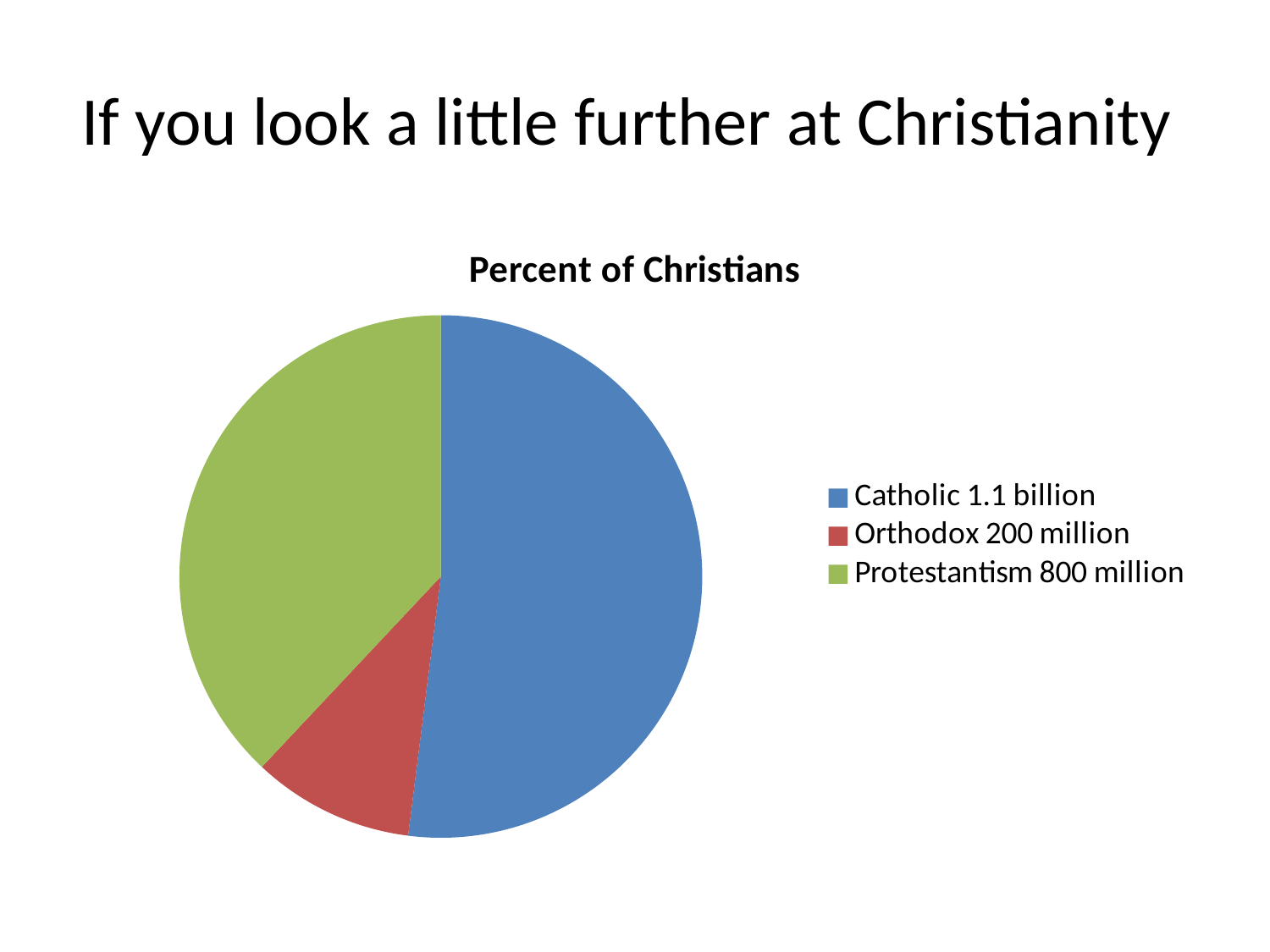
Which group has the smallest slice of the pie? Orthodox What is the title of the chart? Percent of Christians How many slices does the pie chart have? 3 What is the difference between the Protestantism figure and the Orthodox figure shown in the legend? 600 million According to the legend, how many Catholics are there? 1.1 billion Which group has the largest slice of the pie? Catholic Which colour represents Orthodox in the pie chart? Red How many entries does the legend list? 3 What type of chart is shown on the slide? Pie chart According to the legend, how many Orthodox Christians are there? 200 million Which is larger, the Protestantism slice or the Orthodox slice? Protestantism According to the legend, how many Protestants are there? 800 million